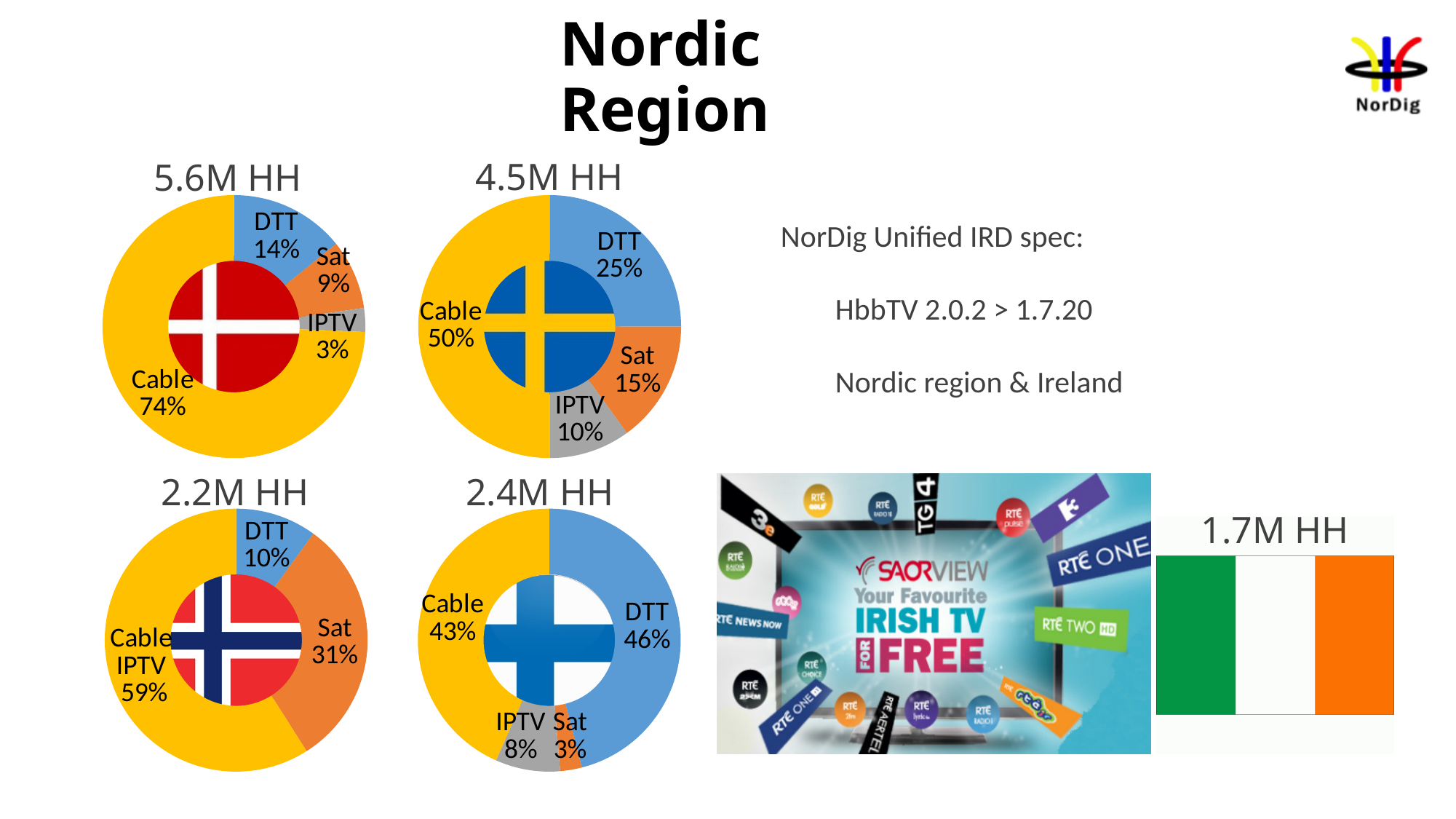
What kind of chart is the 5.6M HH chart (top left)? Pie (donut) chart In the 2.2M HH chart (bottom left), what is the combined share of Cable/IPTV and Sat? 90% In the 5.6M HH chart (top left), which category has the smallest share? IPTV In the 4.5M HH chart (top middle), what is the difference between the Cable share and the DTT share? 25% In the 2.2M HH chart (bottom left), what share does Sat have? 31% How many categories are shown in the 4.5M HH chart (top middle)? 4 In the 2.4M HH chart (bottom middle), which is larger, the Cable share or the DTT share? DTT In the 5.6M HH chart (top left), what share does Cable have? 74% How many categories are shown in the 2.2M HH chart (bottom left)? 3 In the 4.5M HH chart (top middle), what share does DTT have? 25% In the 2.4M HH chart (bottom middle), which category has the largest share? DTT In the 2.4M HH chart (bottom middle), what share does IPTV have? 8%